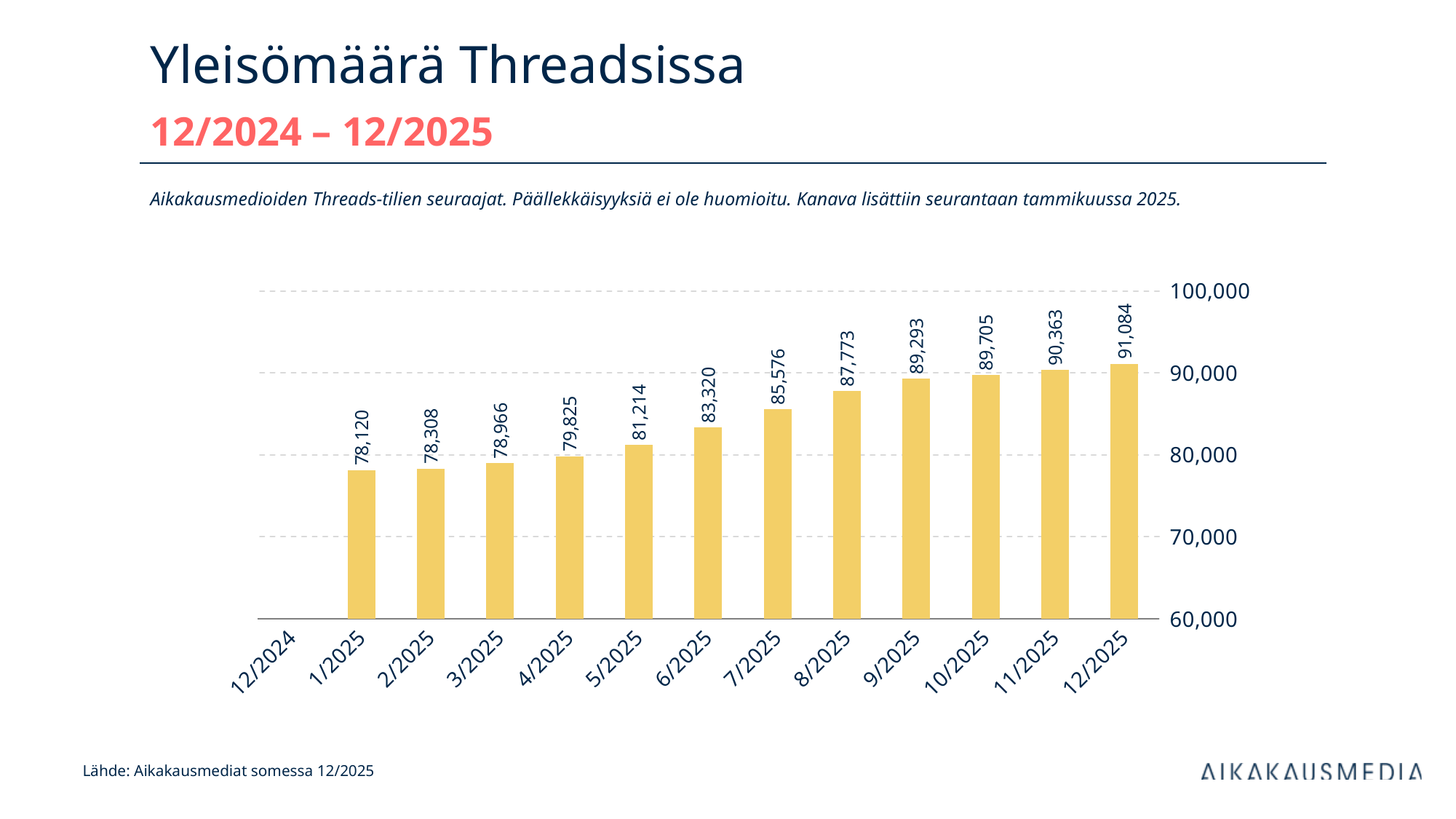
What is the value for 1/2025? 78,120 What is the difference between the values for 12/2025 and 1/2025? 12,964 Is the value for 5/2025 greater or less than 80,000? greater Which month has the highest value? 12/2025 Which month with a bar has the lowest value? 1/2025 What is the difference between the values for 11/2025 and 10/2025? 658 Which is larger, the value for 7/2025 or the value for 4/2025? 7/2025 What is the value for 12/2025? 91,084 How many bars are plotted in the chart? 12 What is the value for 6/2025? 83,320 What kind of chart is shown on the slide? bar chart What is the value for 9/2025? 89,293